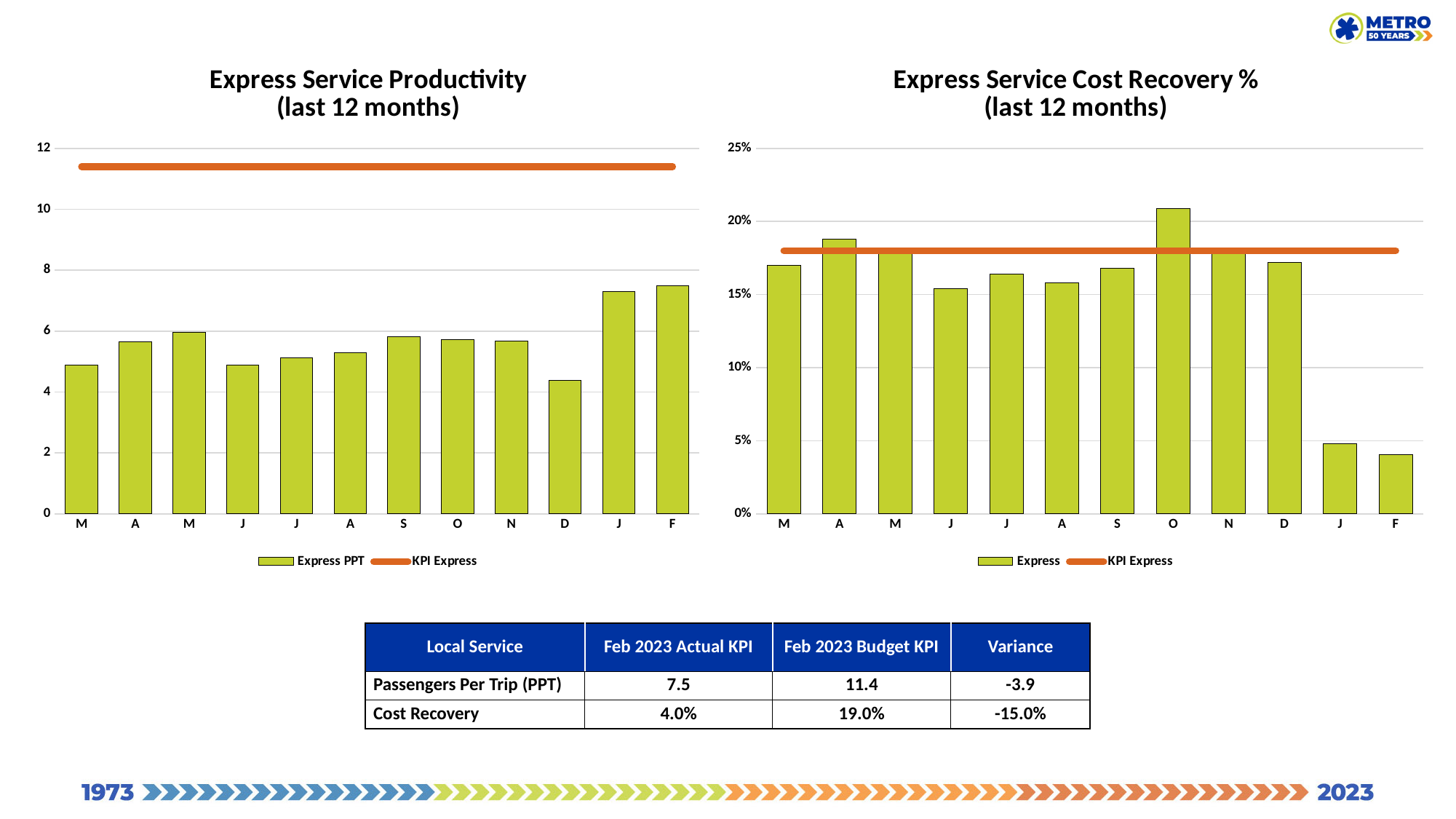
In the Express Service Cost Recovery % chart, which month has the lowest bar? F How many series does the legend of the Express Service Productivity chart list? 2 In the Express Service Cost Recovery % chart, which month has the highest bar? O What are the two legend entries of the Express Service Productivity chart? Express PPT and KPI Express In the Express Service Cost Recovery % chart, is the value for F greater or less than 5%? less What kind of chart is the Express Service Productivity chart on the left? combination bar and line chart In the Express Service Productivity chart, which month has the lowest bar? D How many months are plotted on the x axis of the Express Service Cost Recovery % chart? 12 In the Express Service Productivity chart, is the value for F greater or less than 8? less In the Express Service Cost Recovery % chart, is the value for O greater or less than 20%? greater In the Express Service Cost Recovery % chart, do the bars rise or fall from D to F? fall In the Express Service Cost Recovery % chart, which is larger, the bar for O or the bar for D? O